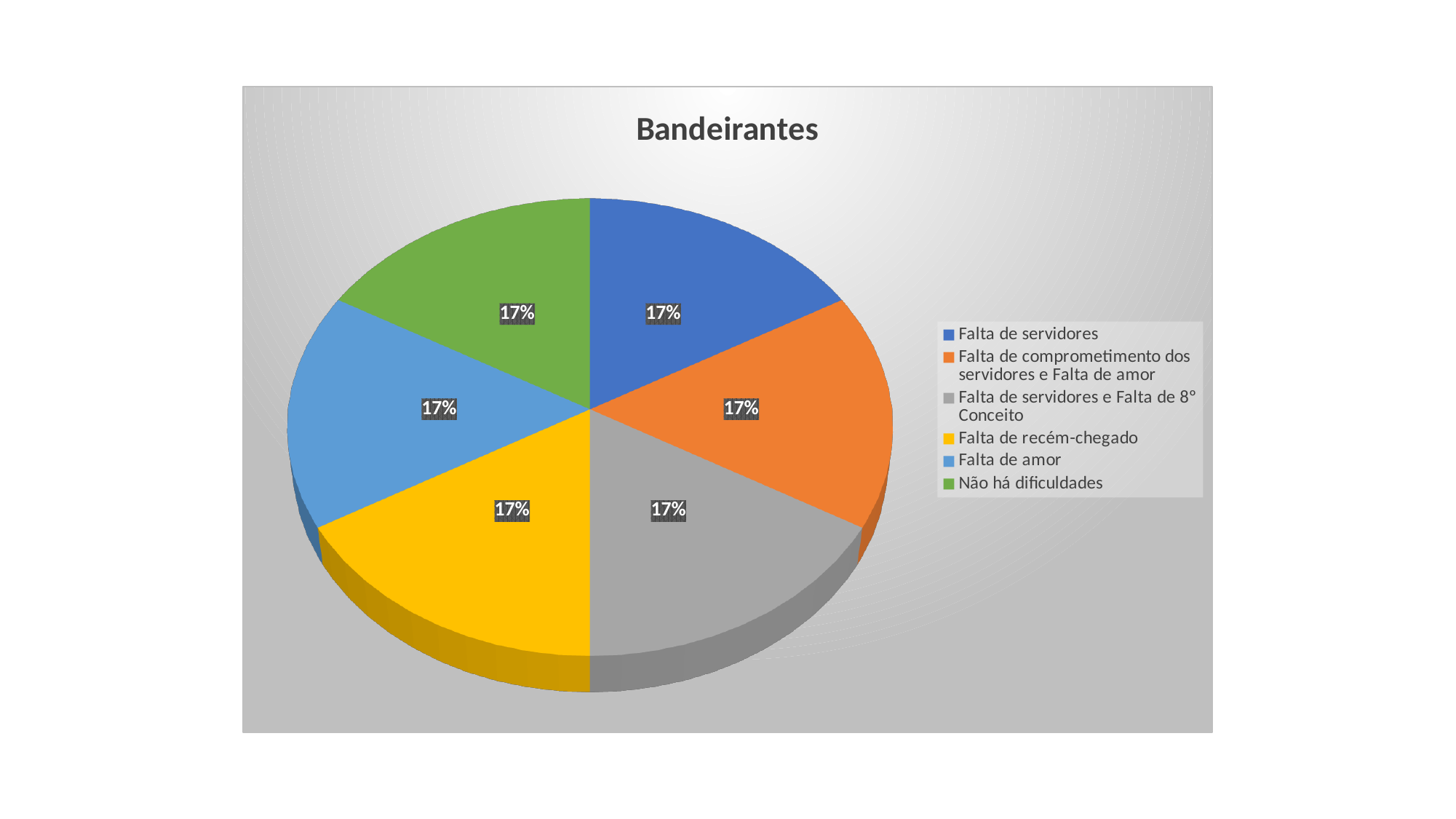
How many slices does the pie chart have? 6 What share of the pie does "Falta de servidores" represent? 17% What is the title of the chart? Bandeirantes What kind of chart is shown on the slide? pie chart What is the value shown for "Falta de amor"? 17% What is the difference between the values for "Falta de servidores" and "Falta de amor"? 0% What is the value shown for "Falta de servidores e Falta de 8° Conceito"? 17% Which colour represents "Falta de recém-chegado" in the legend? yellow What is the value shown for "Falta de recém-chegado"? 17% What is the value shown for "Não há dificuldades"? 17% How many entries does the legend list? 6